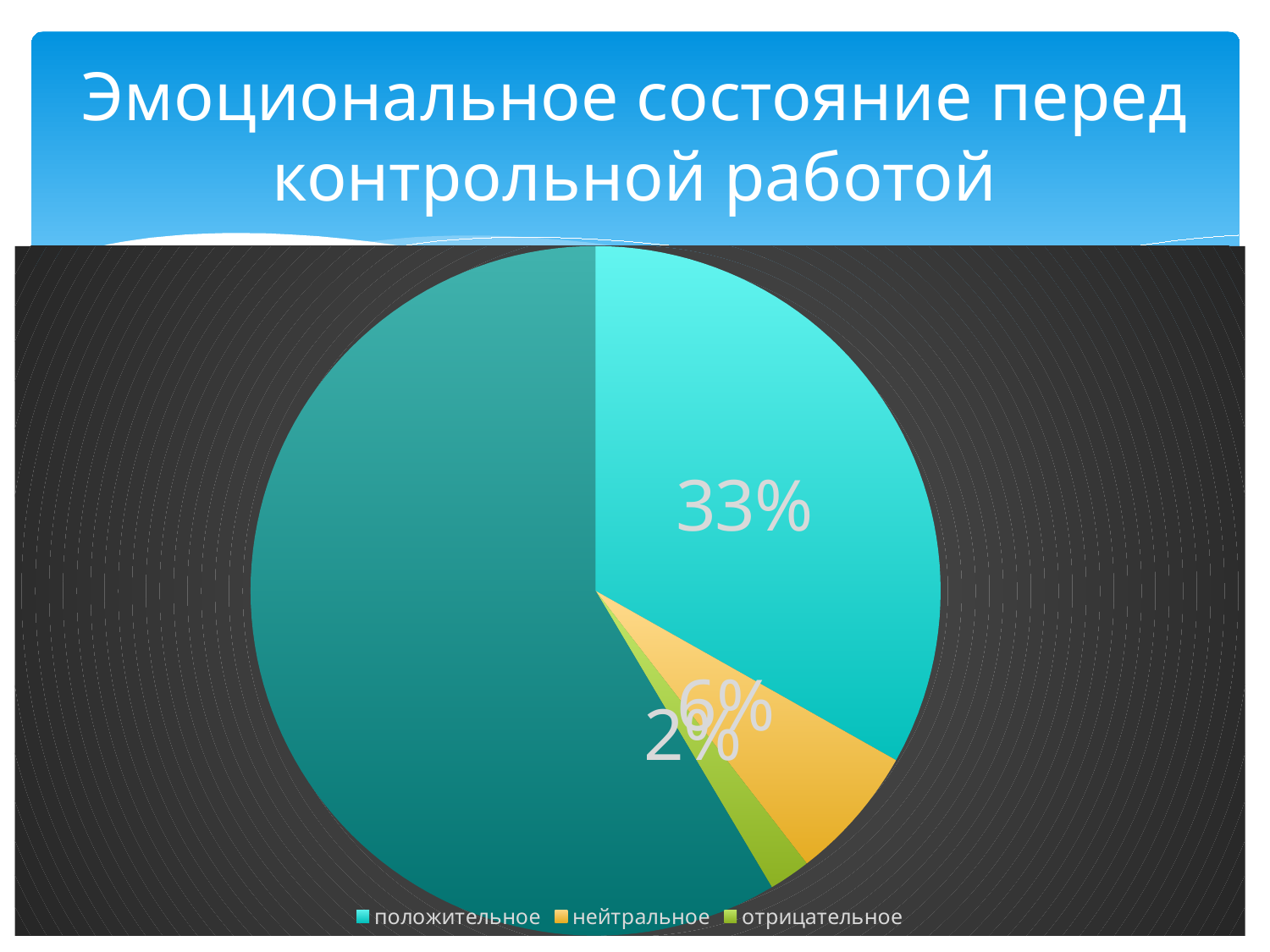
Which is larger, the положительное slice or the нейтральное slice? положительное What percentage is shown for the положительное slice? 33% Which of the legend categories has the smallest share of the pie? отрицательное Which is larger, the нейтральное slice or the отрицательное slice? нейтральное What is the difference in percentage points between the положительное and нейтральное slices? 27% What is the title of the slide? Эмоциональное состояние перед контрольной работой What colour is the нейтральное slice in the pie chart? orange What kind of chart is shown on the slide? pie chart What is the difference in percentage points between the нейтральное and отрицательное slices? 4% What percentage is shown for the нейтральное slice? 6% How many categories does the legend list? 3 What percentage is shown for the отрицательное slice? 2%